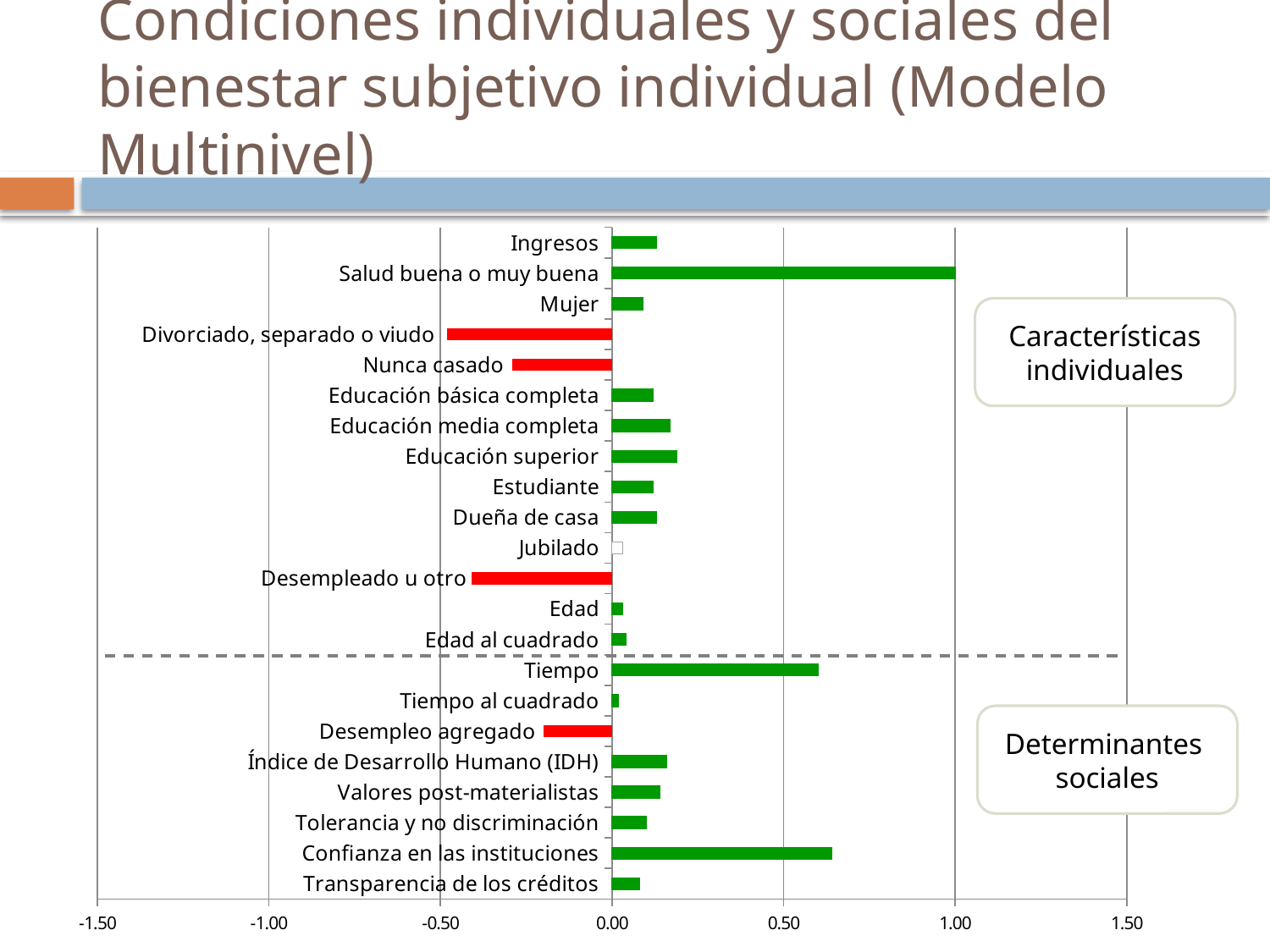
Which category has the lowest (most negative) value in the chart? Divorciado, separado o viudo What are the two group labels shown in the boxes to the right of the chart? Características individuales; Determinantes sociales Is the value for Educación superior greater or less than 0.50? less Is the value for Desempleado u otro greater or less than 0.00? less Is the value for Tiempo greater or less than 0.50? greater What kind of chart is shown on the slide? bar chart What colour are the bars with negative values in the chart? red How many categories are plotted in the chart? 22 Which category has the highest value in the chart? Salud buena o muy buena Which has the lower value, Divorciado, separado o viudo or Nunca casado? Divorciado, separado o viudo Which has the larger value, Educación superior or Mujer? Educación superior